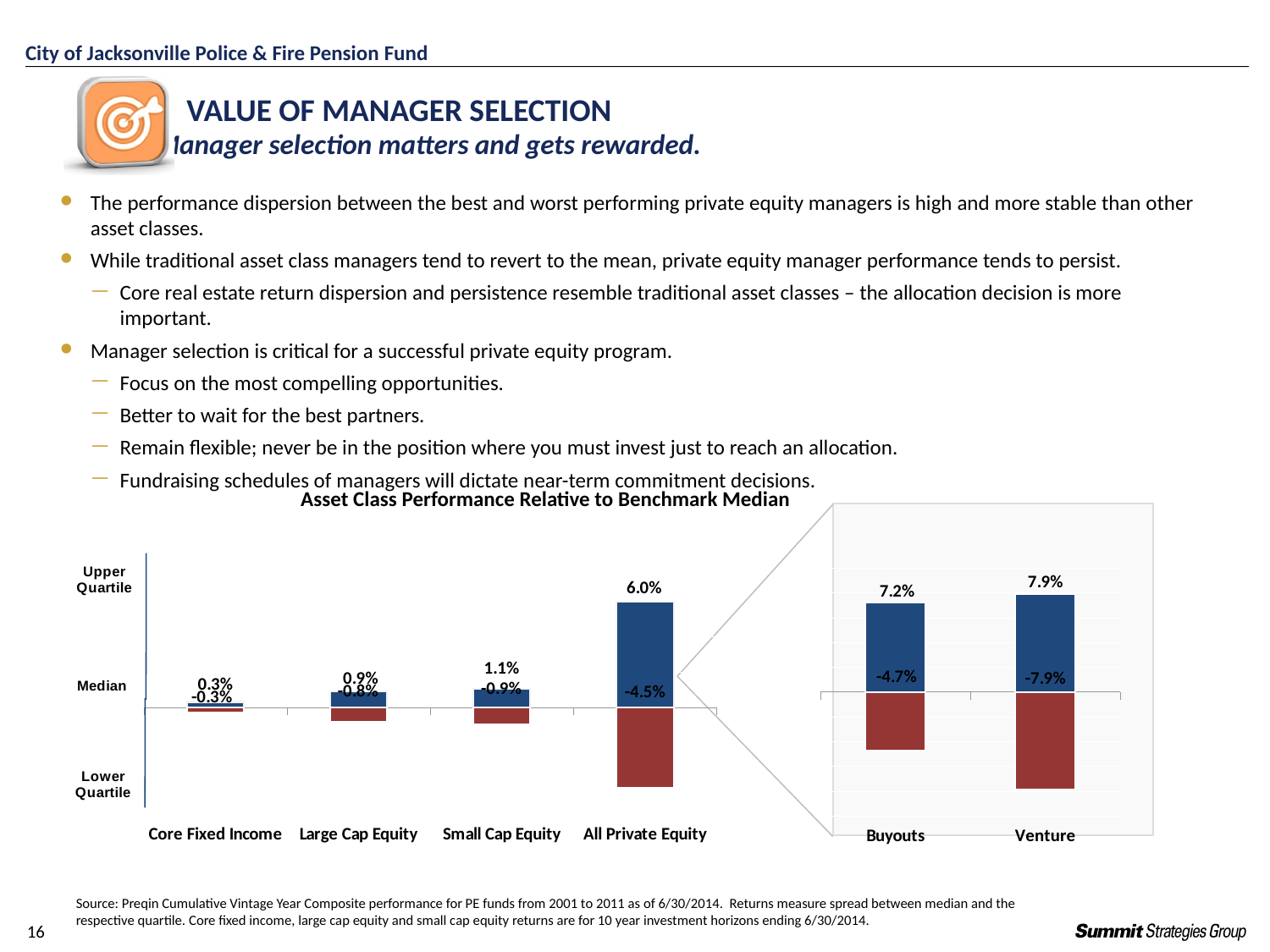
In the main chart, what is the upper quartile value for All Private Equity? 6.0% What kind of chart is shown on the slide? Bar chart In the main chart, which asset class has the highest upper quartile value? All Private Equity In the main chart, which asset class has the smallest upper quartile value? Core Fixed Income In the main chart, what is the lower quartile value for All Private Equity? -4.5% In the inset chart on the right, what is the upper quartile value for Venture? 7.9% What is the title of the chart on the slide? Asset Class Performance Relative to Benchmark Median In the main chart, what is the upper quartile value for Core Fixed Income? 0.3% In the main chart, what is the upper quartile value for Small Cap Equity? 1.1% In the inset chart on the right, which category has the larger upper quartile value, Buyouts or Venture? Venture In the inset chart on the right, what is the lower quartile value for Buyouts? -4.7% In the main chart, how many asset classes are shown on the x axis? 4